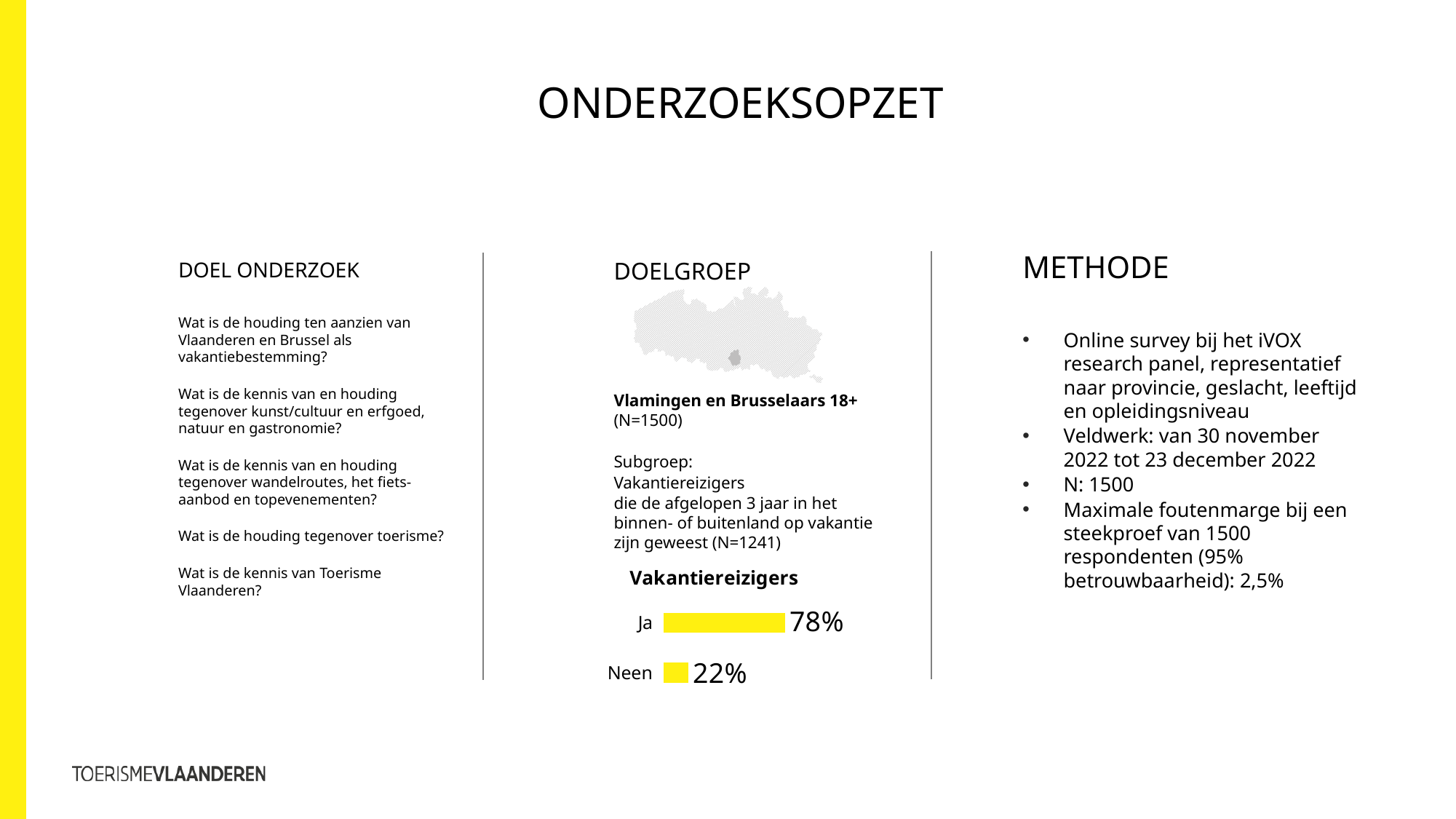
What is the value for Neen in the Vakantiereizigers chart? 22% What is the value for Ja in the Vakantiereizigers chart? 78% What is the title of the chart on the slide? Vakantiereizigers Which is larger in the Vakantiereizigers chart, Ja or Neen? Ja Which category has the lowest value in the Vakantiereizigers chart? Neen What is the total of the Ja and Neen values in the Vakantiereizigers chart? 100% What is the difference between the values for Ja and Neen in the Vakantiereizigers chart? 56% How many categories are shown in the Vakantiereizigers chart? 2 What colour are the bars in the Vakantiereizigers chart? Yellow What kind of chart is the Vakantiereizigers chart? Bar chart Which category has the highest value in the Vakantiereizigers chart? Ja